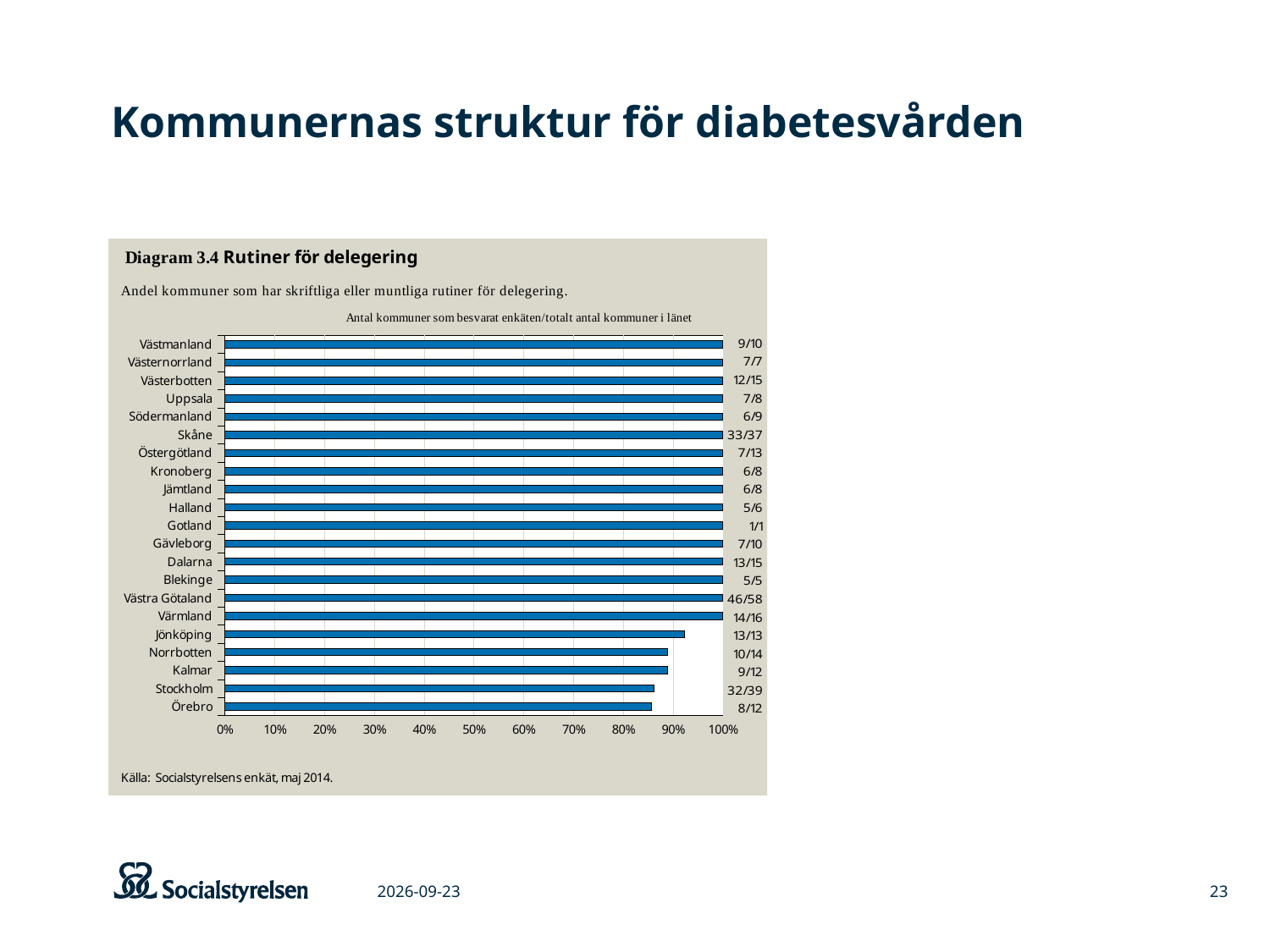
What label (responding municipalities/total municipalities) is printed next to the bar for Skåne? 33/37 How many counties (categories) are plotted in the chart? 21 Which has the larger value, Västmanland or Stockholm? Västmanland Is the value for Örebro greater or less than 90%? less What label is printed next to the bar for Västra Götaland? 46/58 What is the value for Västmanland? 100% Is the value for Jönköping greater or less than 90%? greater What is the value for Värmland? 100% What kind of chart is shown on the slide? bar chart What is the title of the chart? Diagram 3.4 Rutiner för delegering Which has the larger value, Jönköping or Örebro? Jönköping What label is printed next to the bar for Stockholm? 32/39